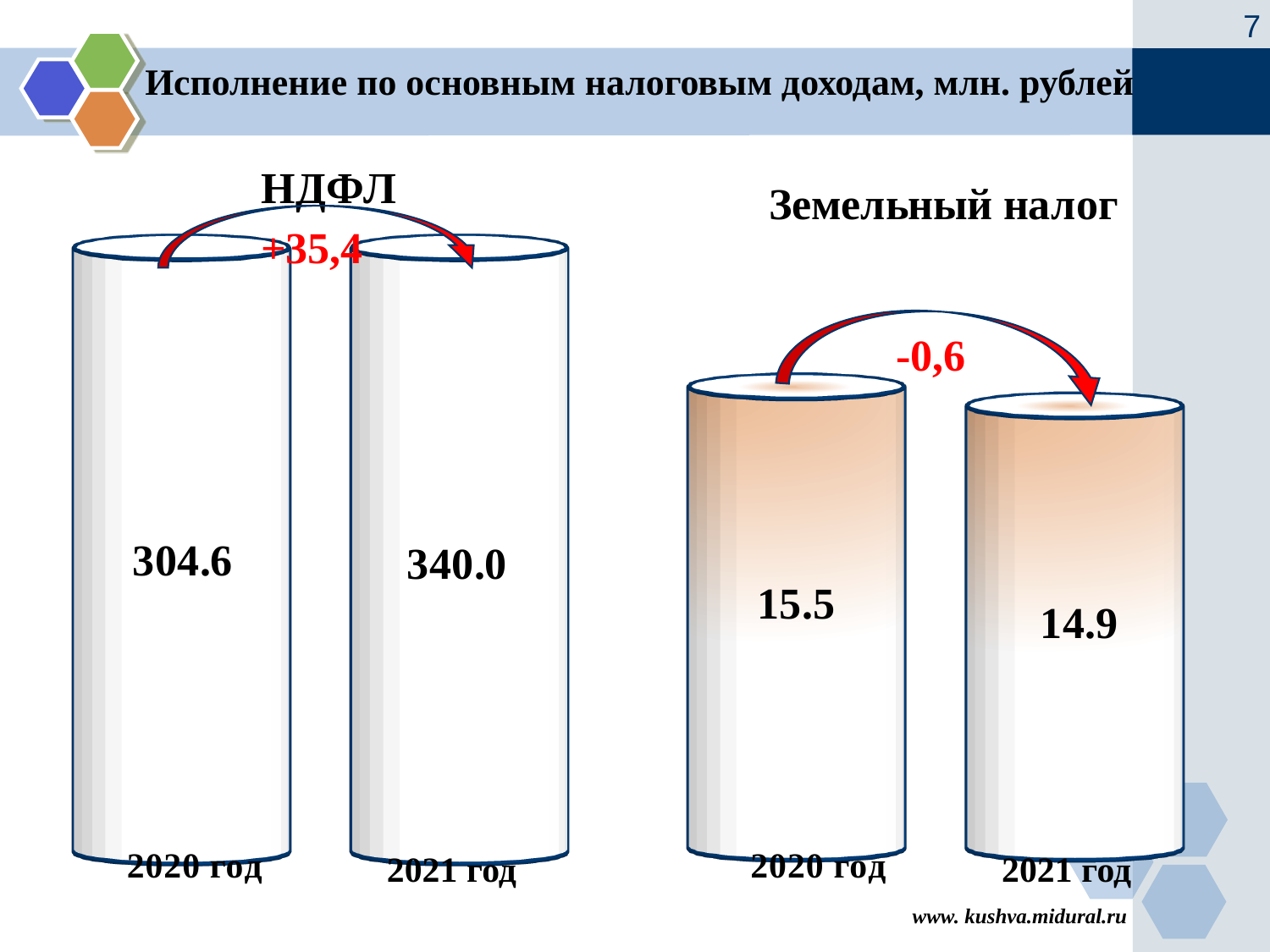
In the НДФЛ chart, which year has the higher value? 2021 год In the НДФЛ chart, do the values rise or fall from 2020 год to 2021 год? rise In the Земельный налог chart, what is the value for 2020 год? 15.5 In the НДФЛ chart, what is the value for 2021 год? 340.0 What change is annotated with the red arrow on the Земельный налог chart? -0,6 In the Земельный налог chart, is the value for 2020 год larger or smaller than the value for 2021 год? larger In the Земельный налог chart, what is the value for 2021 год? 14.9 In the НДФЛ chart, what is the difference between the 2021 год and 2020 год values? 35.4 In the НДФЛ chart, what is the value for 2020 год? 304.6 In the Земельный налог chart, what is the difference between the 2020 год and 2021 год values? 0.6 In the Земельный налог chart, which year has the lower value? 2021 год How many categories (years) does the Земельный налог chart show? 2